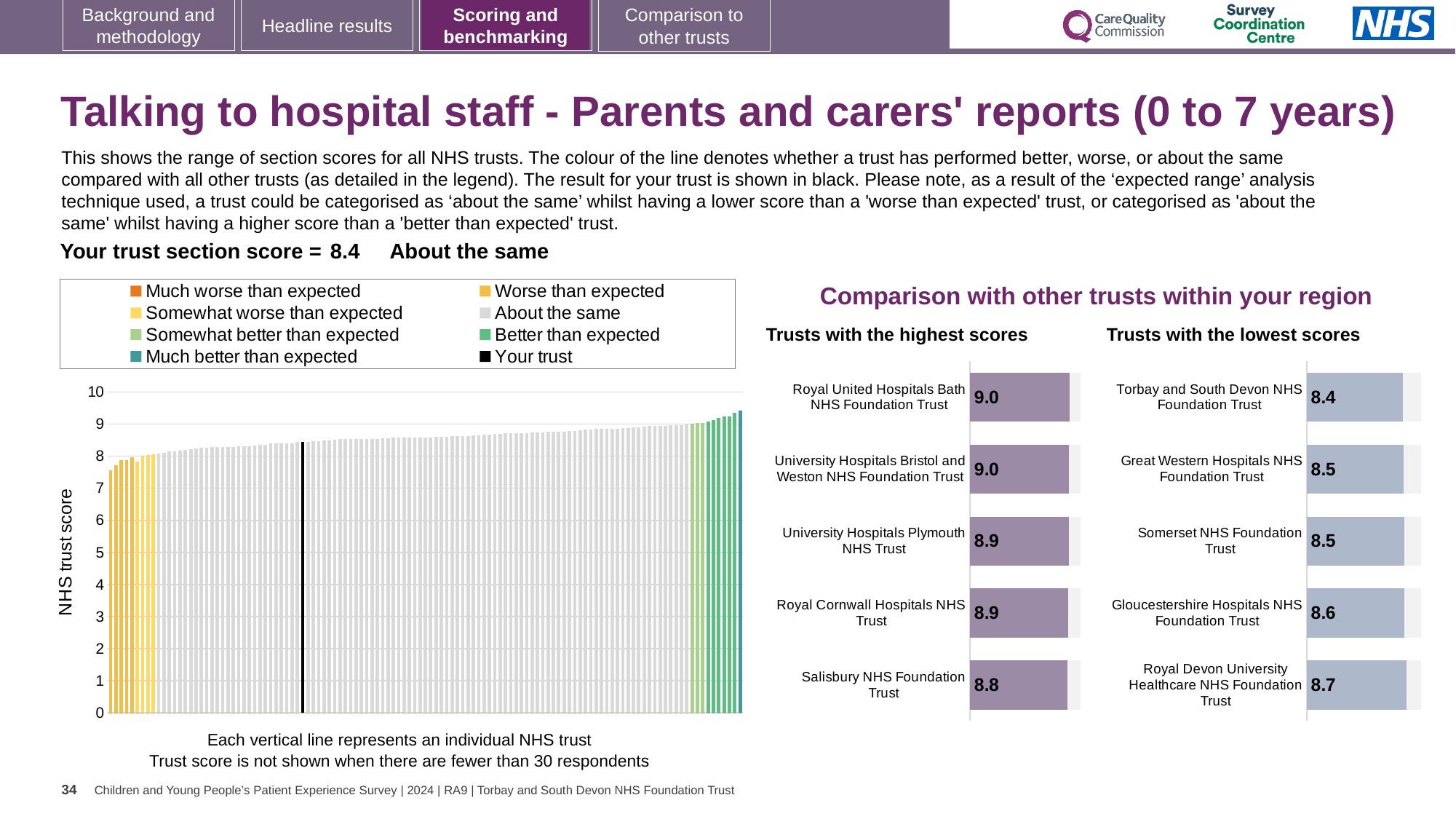
In the 'Trusts with the highest scores' chart, which trust has the lowest score? Salisbury NHS Foundation Trust In the 'Trusts with the lowest scores' chart, which has the larger score: Gloucestershire Hospitals NHS Foundation Trust or Torbay and South Devon NHS Foundation Trust? Gloucestershire Hospitals NHS Foundation Trust In the 'Trusts with the lowest scores' chart, what is the score for Gloucestershire Hospitals NHS Foundation Trust? 8.6 In the large chart on the left, is the value for 'Your trust' (the black line) greater or less than 8? greater In the 'Trusts with the highest scores' chart, how many trusts are shown? 5 In the large chart on the left, is the value of the lowest (leftmost) bar greater or less than 8? less What kind of chart is the large chart on the left with the y axis labelled 'NHS trust score'? bar chart In the large chart on the left, do the bar values rise or fall from left to right along the x axis? rise In the 'Trusts with the highest scores' chart, what is the score for Salisbury NHS Foundation Trust? 8.8 In the 'Trusts with the lowest scores' chart, what is the difference between the scores of Royal Devon University Healthcare NHS Foundation Trust and Torbay and South Devon NHS Foundation Trust? 0.3 In the 'Trusts with the lowest scores' chart, which trust has the highest score? Royal Devon University Healthcare NHS Foundation Trust In the large chart on the left, how many entries does the legend list? 8